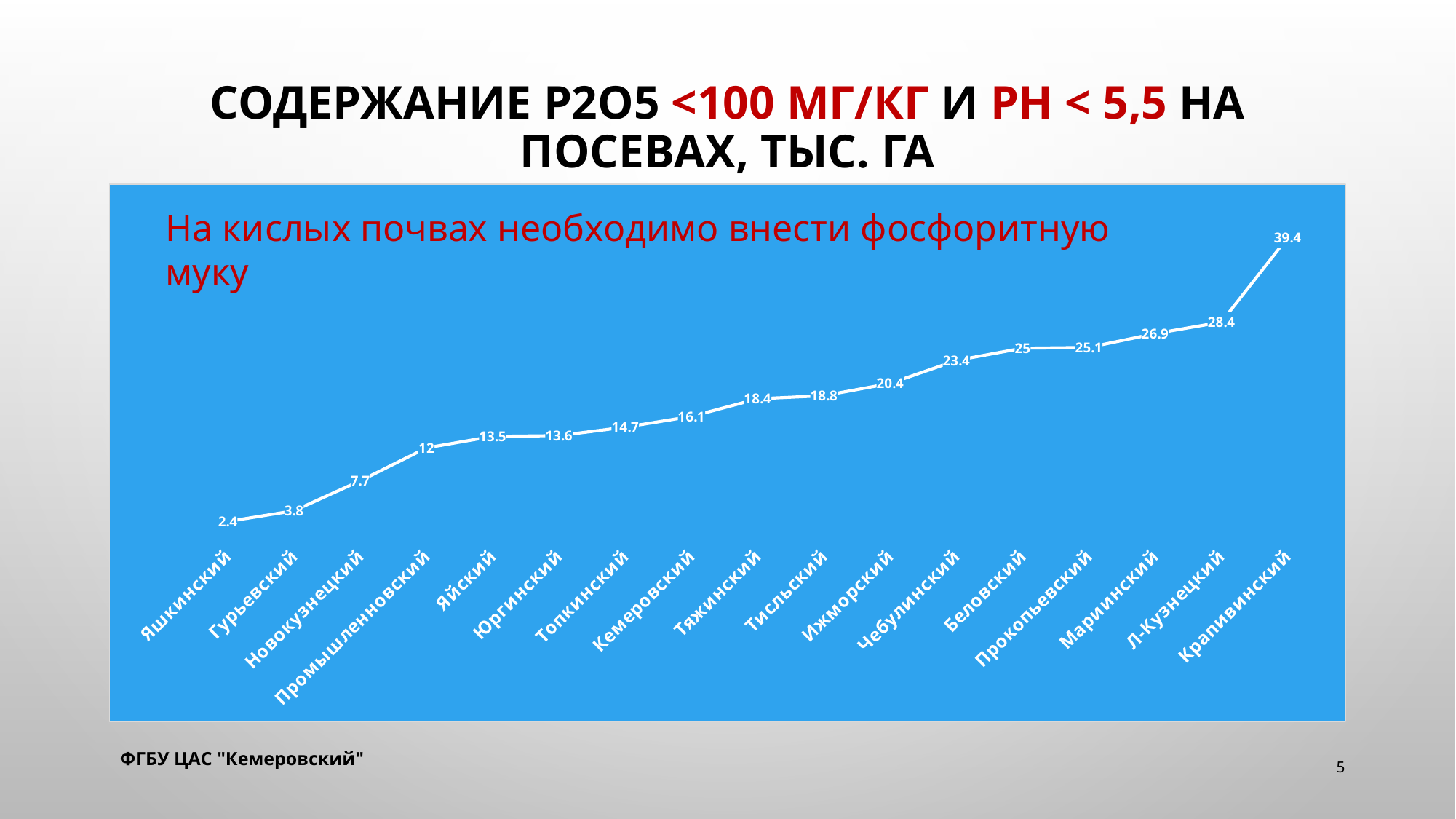
Which is larger, the value for Чебулинский or the value for Ижморский? Чебулинский What is the difference between the values for Гурьевский and Яшкинский? 1.4 What is the difference between the values for Крапивинский and Л-Кузнецкий? 11 How many districts are plotted on the chart? 17 What is the value for Крапивинский? 39.4 Which district has the highest value? Крапивинский What is the red text written inside the chart area? На кислых почвах необходимо внести фосфоритную муку Which district has the lowest value? Яшкинский Do the values rise or fall from left to right along the x axis? Rise What kind of chart is shown on the slide? Line chart What is the value for Промышленновский? 12